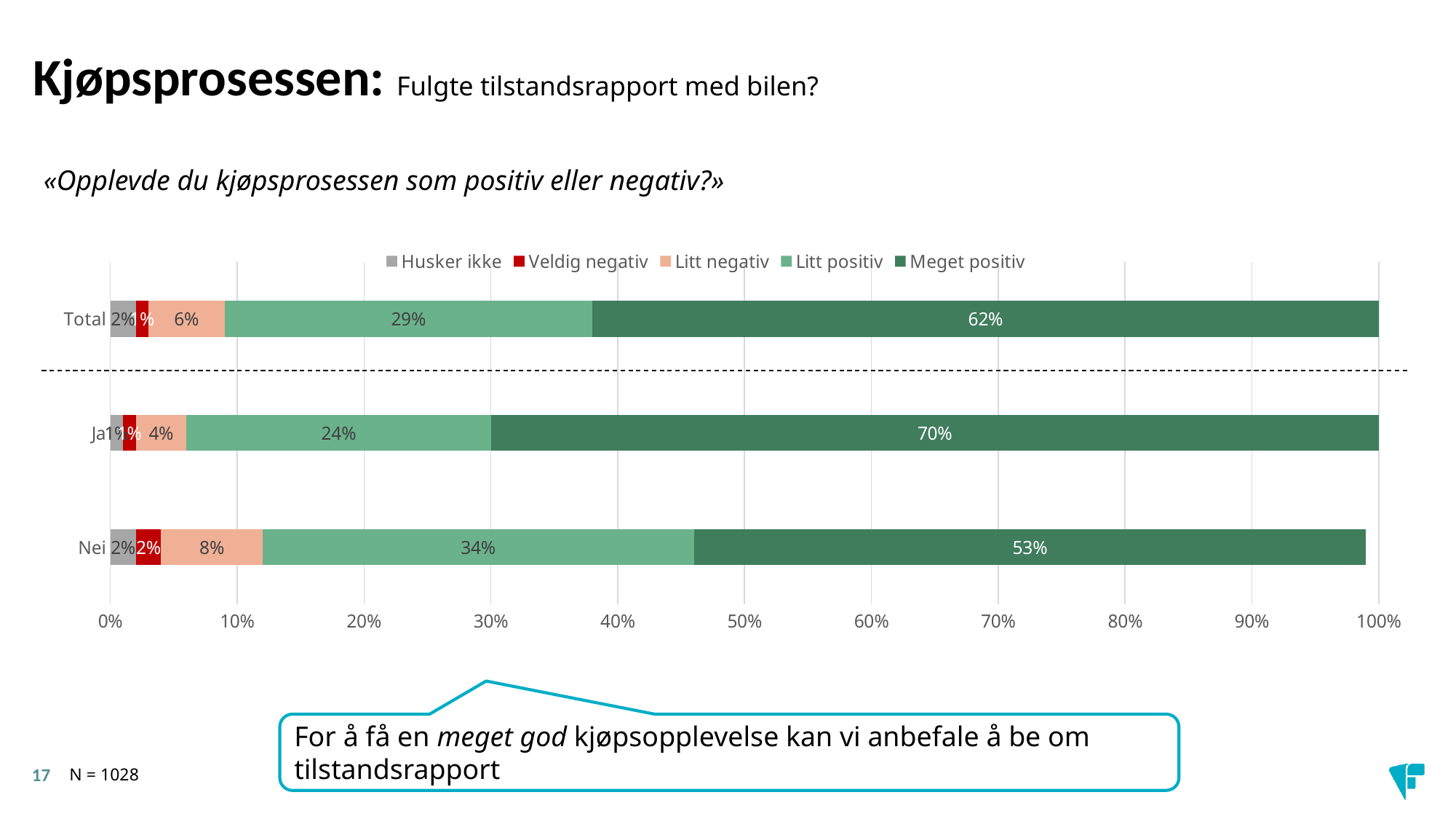
What is the value of 'Litt positiv' for the 'Nei' category? 34% What is the difference between the 'Meget positiv' values for 'Ja' and 'Nei'? 17 percentage points What kind of chart is shown on the slide? Stacked bar chart Which category has the highest value for 'Meget positiv'? Ja What is the value of 'Veldig negativ' for the 'Nei' category? 2% What is the value of 'Meget positiv' for the 'Ja' category? 70% Which category has the lowest value for 'Litt positiv'? Ja Which legend entry is shown in red? Veldig negativ Which is larger: 'Litt negativ' for 'Nei' or 'Litt negativ' for 'Ja'? Nei What is the value of 'Litt negativ' for the 'Total' category? 6% How many series does the legend list? 5 How many categories (bars) are shown in the chart? 3